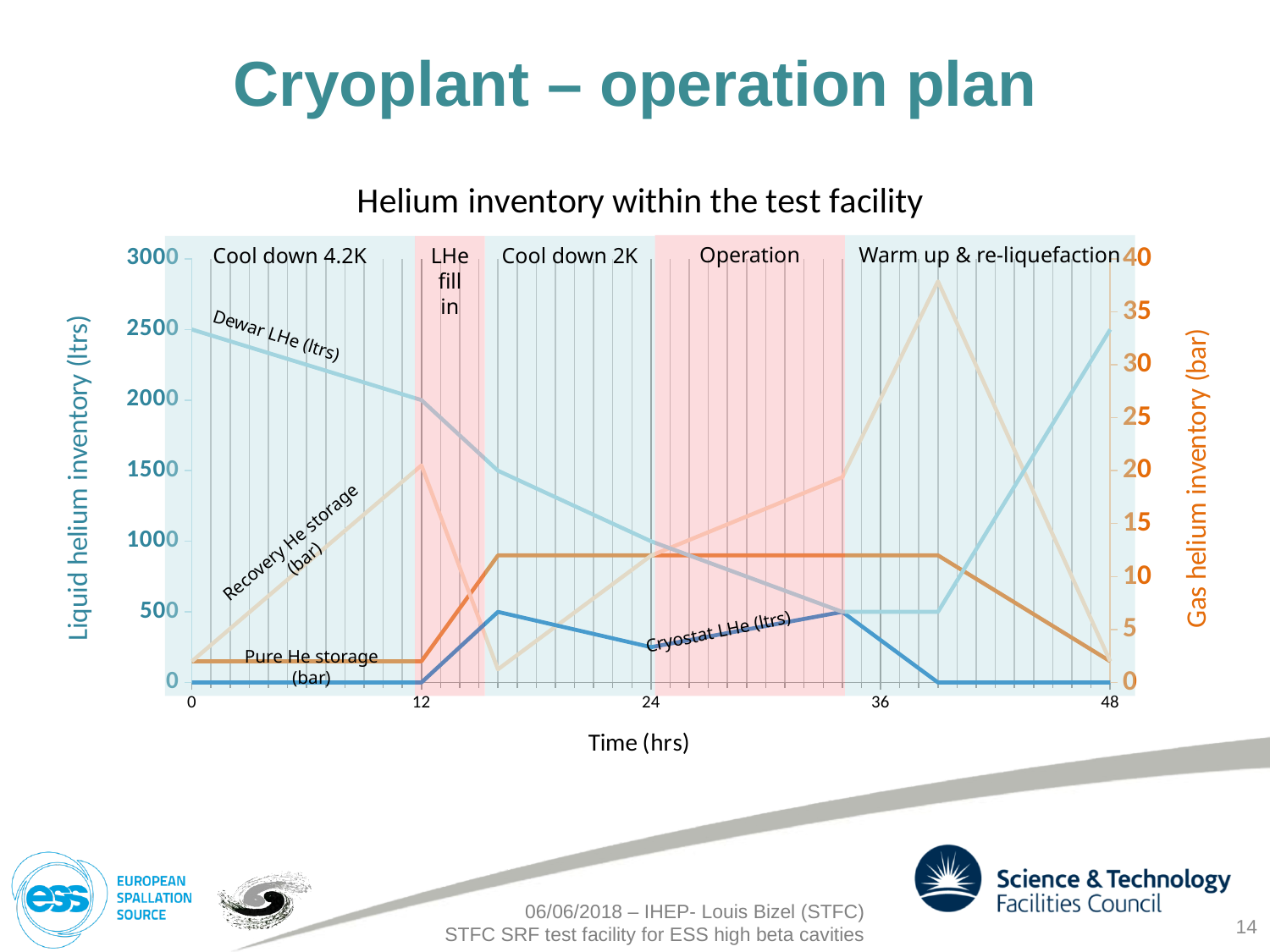
Is the peak value of Recovery He storage greater or less than 35 bar? greater What kind of chart is shown on the slide? line chart What is the Cryostat LHe value at 0 hrs? 0 How many data series are labelled on the chart? 4 What is the label of the right-hand vertical axis? Gas helium inventory (bar) Does the Dewar LHe line rise or fall between 0 and 12 hrs? fall What is the Dewar LHe value at 0 hrs? 2500 What is the Dewar LHe value at 48 hrs? 2500 Is the Dewar LHe value at 36 hrs greater or less than 1000? less What is the Dewar LHe value at 12 hrs? 2000 What is the title of the chart? Helium inventory within the test facility